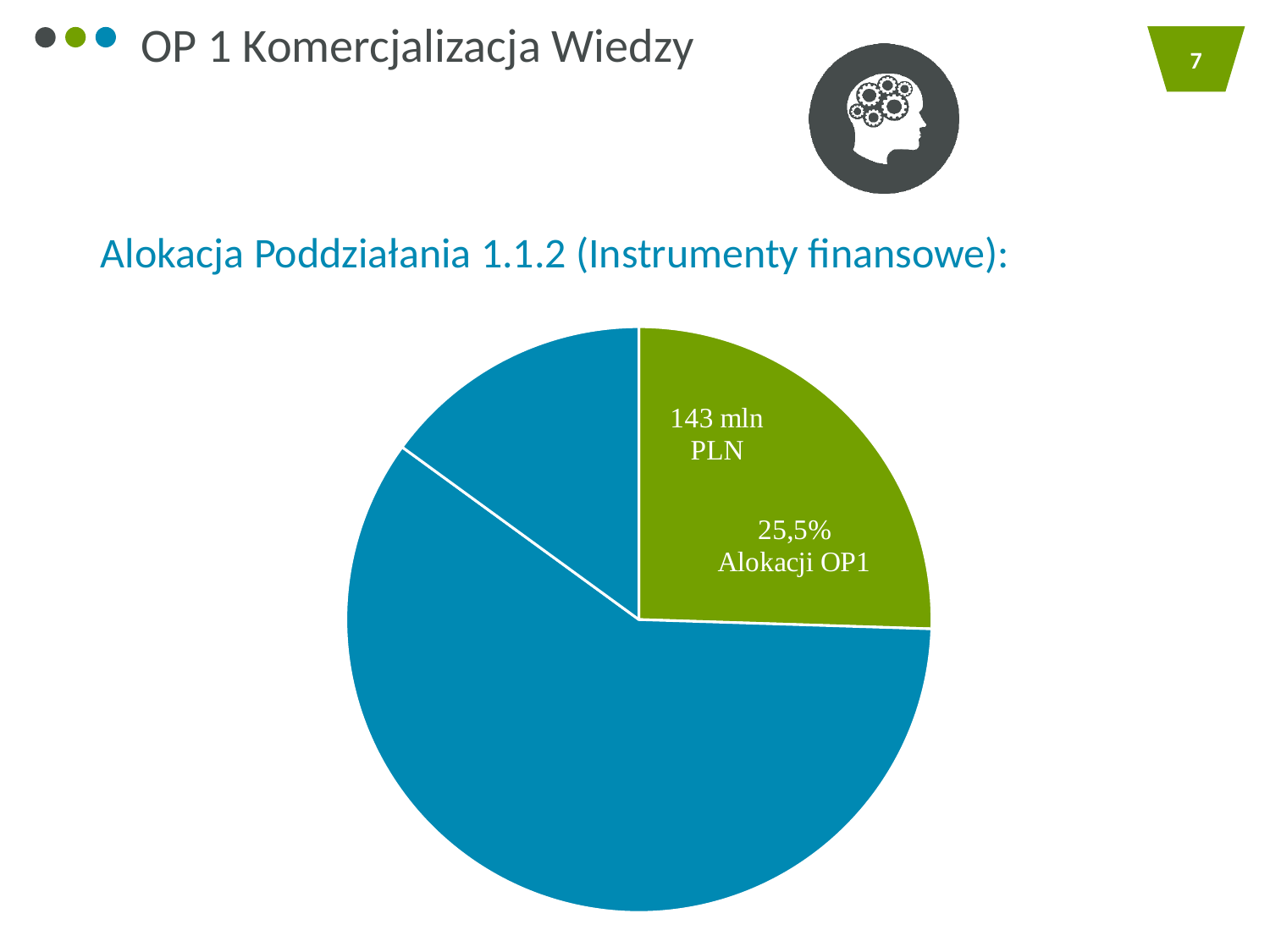
What is the title printed above the pie chart? Alokacja Poddziałania 1.1.2 (Instrumenty finansowe): Which colour occupies the largest part of the pie chart? blue What share of the OP1 allocation does the green slice represent? 25,5% What colour is the slice labelled 143 mln PLN? green Is the share of the green slice greater or less than 50%? less What kind of chart is shown on the slide? pie chart Which is larger in the pie chart, the green slice or the blue area? the blue area What amount in PLN is printed on the green slice of the pie chart? 143 mln PLN